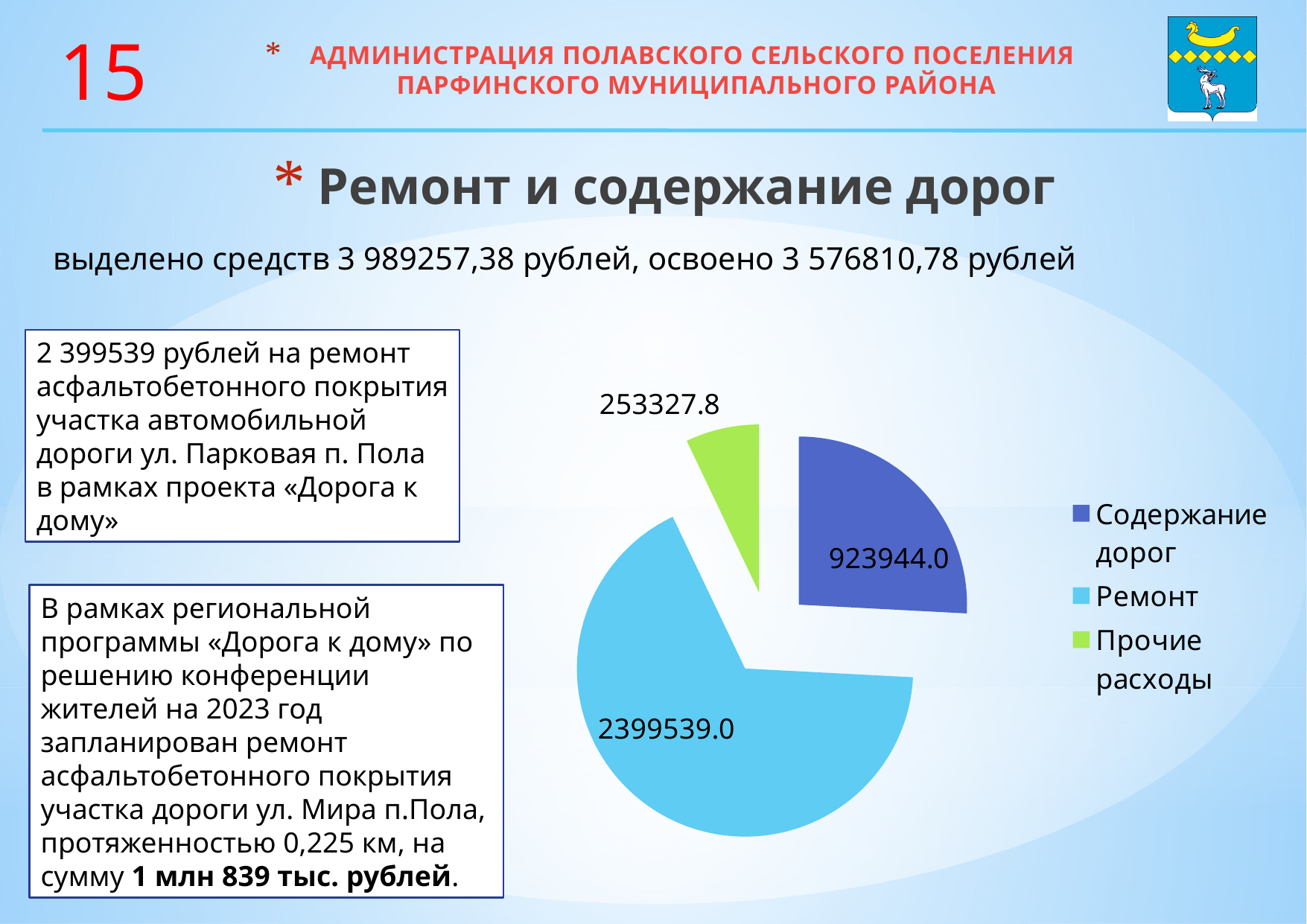
What is the total of all slices in the pie chart? 3576810.8 What is the value for Ремонт in the pie chart? 2399539.0 Which category has the largest slice in the pie chart? Ремонт Which is larger in the pie chart, Содержание дорог or Прочие расходы? Содержание дорог What is the value for Прочие расходы in the pie chart? 253327.8 What is the value for Содержание дорог in the pie chart? 923944.0 What colour is the Ремонт slice in the pie chart? Light blue How many entries does the legend of the pie chart list? 3 How many slices does the pie chart have? 3 What is the difference between the values for Ремонт and Содержание дорог in the pie chart? 1475595.0 Which category has the smallest slice in the pie chart? Прочие расходы What type of chart is shown on the slide? Pie chart